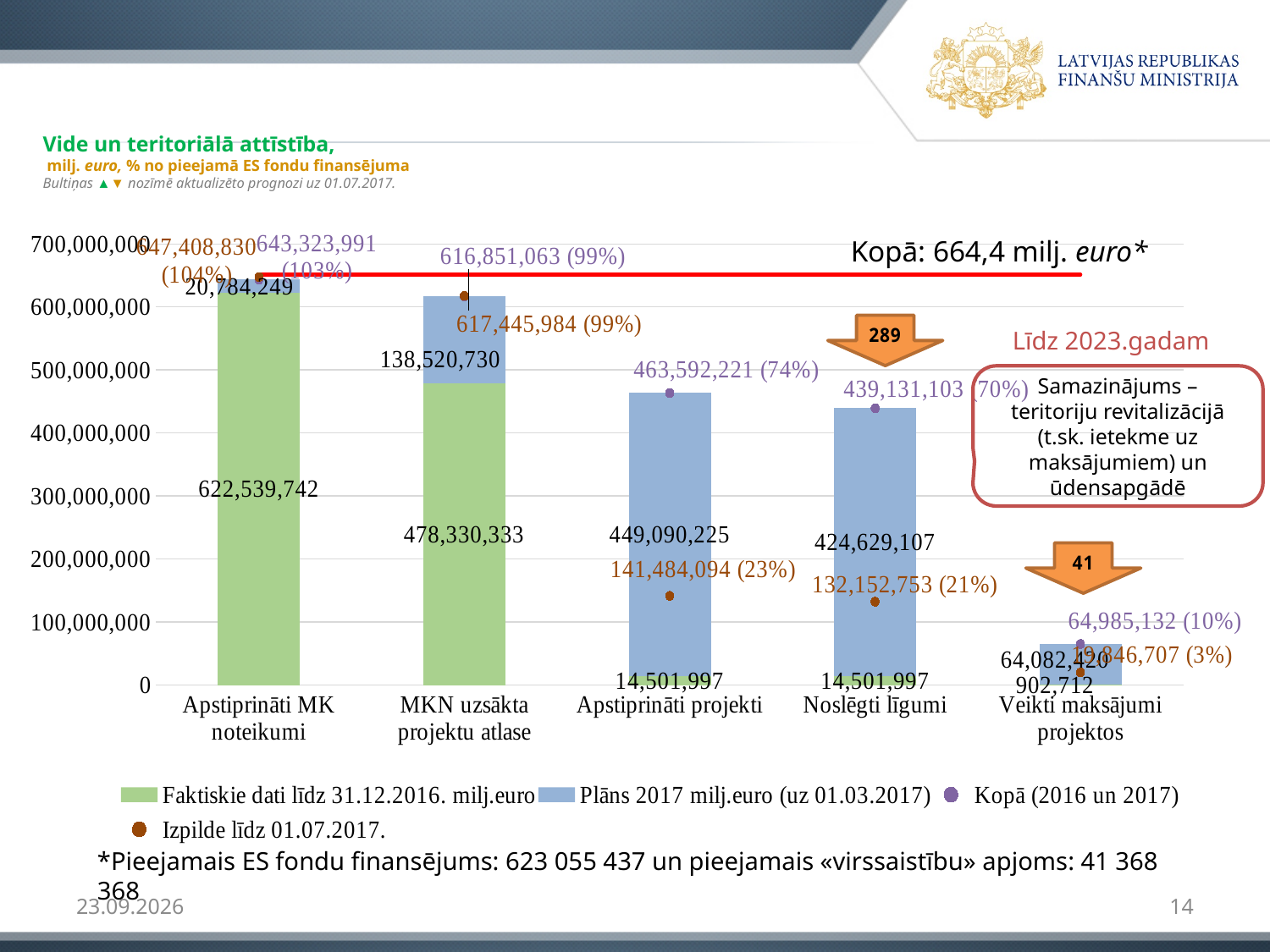
How many categories are shown on the x axis of the chart? 5 How many series does the chart legend list? 4 Which category has the highest 'Faktiskie dati līdz 31.12.2016.' value? Apstiprināti MK noteikumi What is the 'Plāns 2017' value for 'Apstiprināti projekti'? 449,090,225 What is the total of the stacked bar for 'Apstiprināti MK noteikumi' (green plus blue segments)? 643,323,991 Which category has the lowest 'Kopā (2016 un 2017)' value? Veikti maksājumi projektos What is the difference between the 'Plāns 2017' values for 'Apstiprināti projekti' and 'Noslēgti līgumi'? 24,461,118 What kind of chart is shown on the slide? Stacked bar chart Which has the larger 'Izpilde līdz 01.07.2017.' value: 'Apstiprināti projekti' or 'Noslēgti līgumi'? Apstiprināti projekti What is the value of 'Faktiskie dati līdz 31.12.2016.' for 'MKN uzsākta projektu atlase'? 478,330,333 What is the 'Kopā (2016 un 2017)' value labelled for 'Noslēgti līgumi'? 439,131,103 (70%) What is the 'Izpilde līdz 01.07.2017.' value labelled for 'Veikti maksājumi projektos'? 19,846,707 (3%)